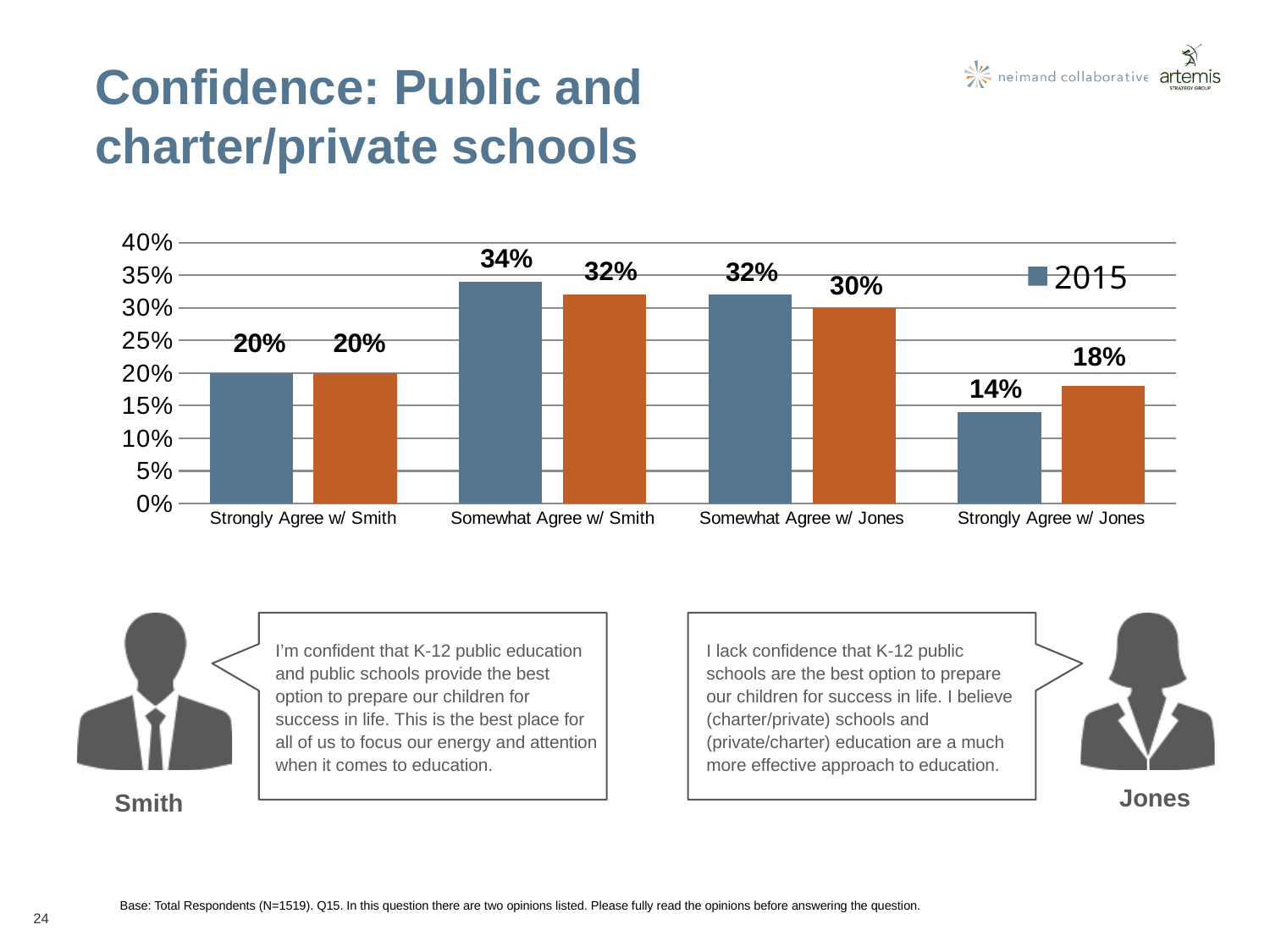
What entry does the chart legend show? 2015 Which category has the lowest 2015 value? Strongly Agree w/ Jones What is the 2015 value for Somewhat Agree w/ Smith? 34% What kind of chart is shown on the slide? Bar chart For Strongly Agree w/ Jones, which is larger: the 2015 (blue) bar or the orange bar? The orange bar What is the difference between the 2015 values for Somewhat Agree w/ Smith and Strongly Agree w/ Jones? 20 percentage points What is the 2015 value for Strongly Agree w/ Jones? 14% Which category has the highest 2015 value? Somewhat Agree w/ Smith What value does the orange bar show for Strongly Agree w/ Jones? 18% What value does the orange bar show for Somewhat Agree w/ Smith? 32% How many categories are shown on the x axis? 4 Is the orange bar for Somewhat Agree w/ Jones greater or less than 25%? greater